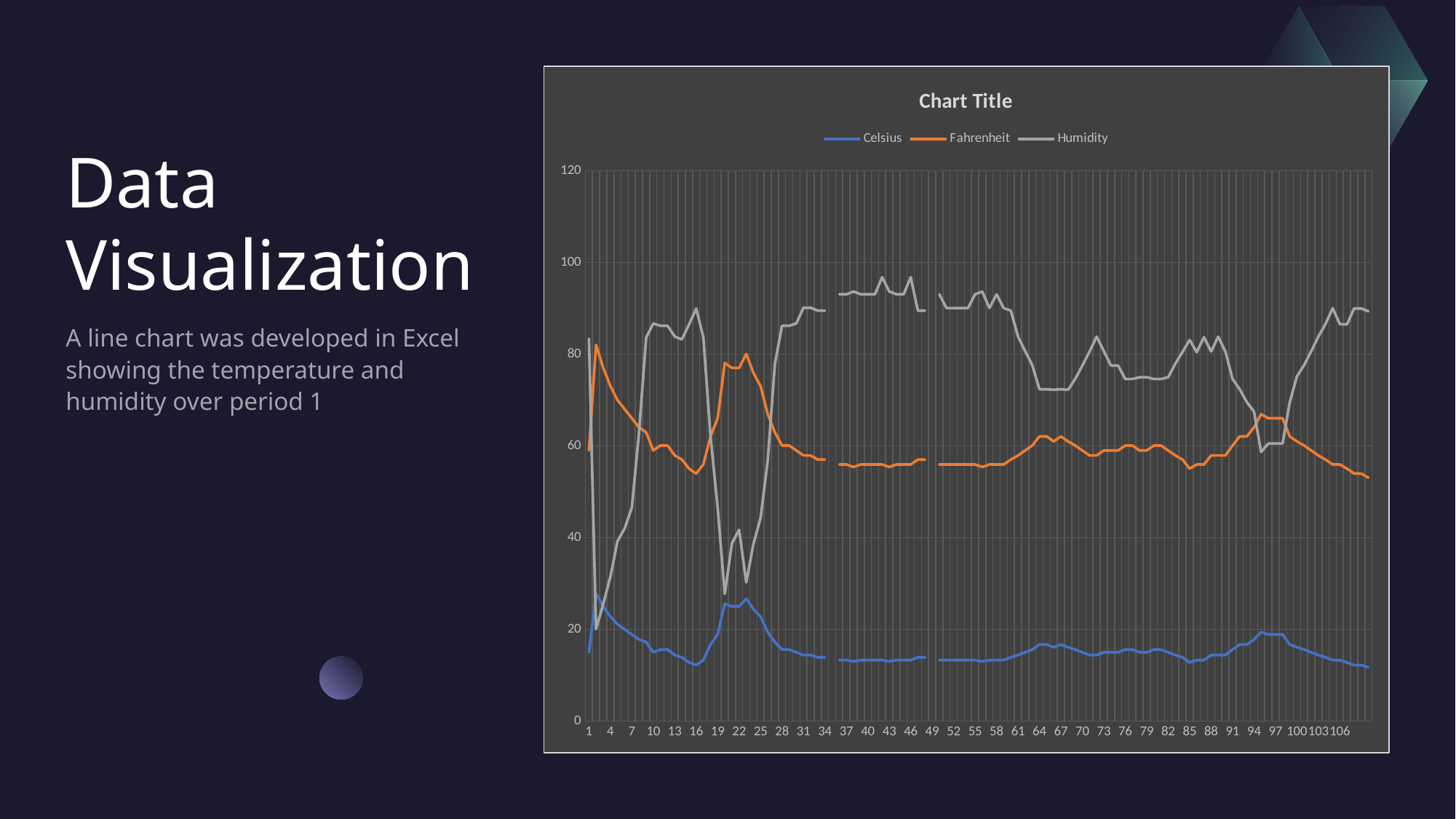
Is the Fahrenheit value at point 40 greater or less than 60? less Which series has the lowest values across the whole chart? Celsius Does the Fahrenheit line rise or fall between point 4 and point 16? fall What kind of chart is shown on the slide? line chart How many series does the chart's legend list? 3 Is the Celsius value at point 40 greater or less than 20? less Is the Humidity value at point 64 greater or less than 60? greater What is the title shown above the chart? Chart Title What are the three series named in the chart's legend? Celsius, Fahrenheit, Humidity At point 40, which series has the higher value, Humidity or Fahrenheit? Humidity